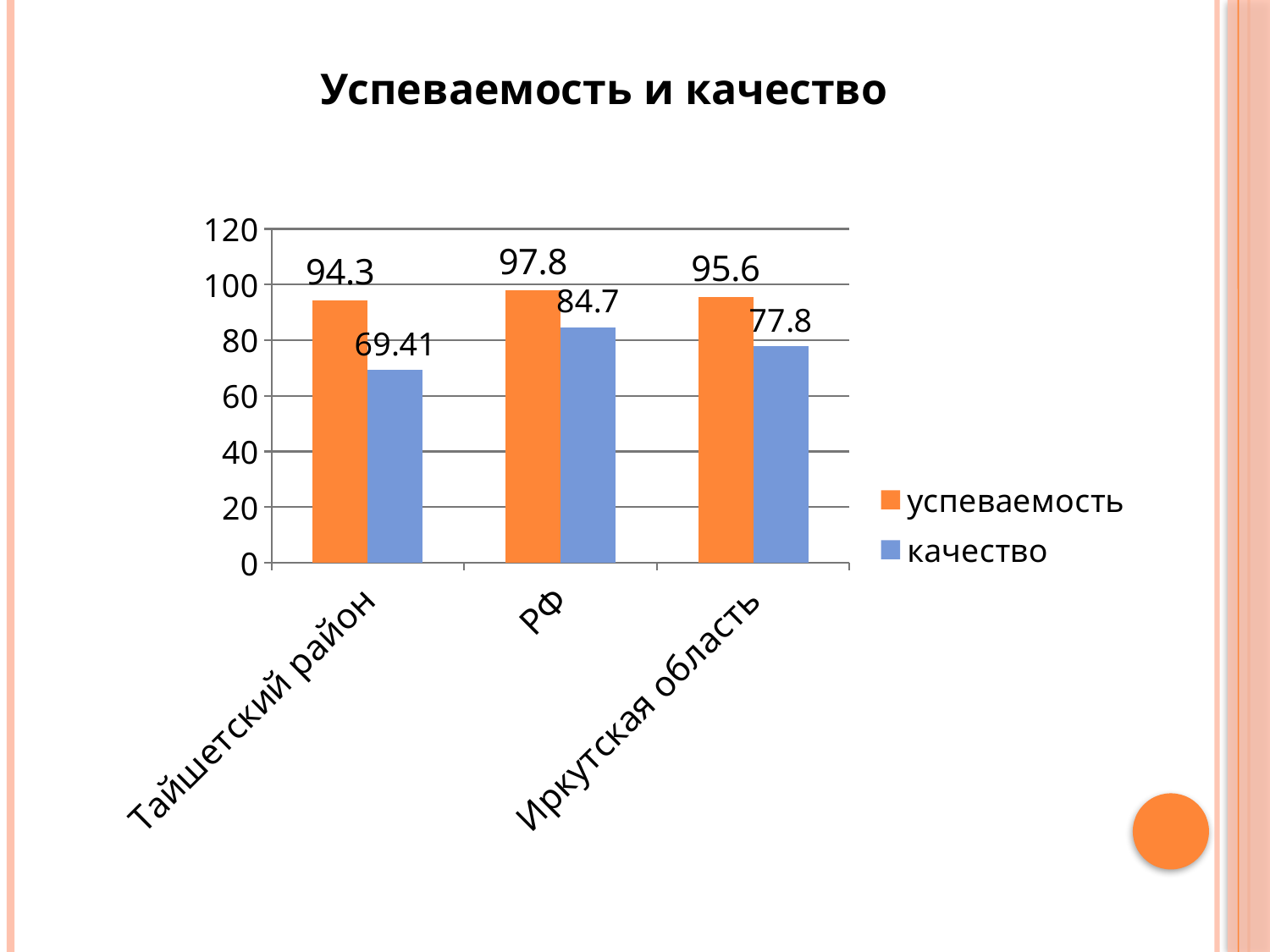
What is the difference between the качество values for РФ and Иркутская область? 6.9 What is the качество value for РФ? 84.7 Which category has the highest успеваемость value? РФ What is the difference between the успеваемость and качество values for Тайшетский район? 24.89 What is the успеваемость value for Тайшетский район? 94.3 What is the качество value for Иркутская область? 77.8 Which is larger: the успеваемость value for Иркутская область or the успеваемость value for Тайшетский район? Иркутская область What kind of chart is shown on the slide? bar chart Which category has the lowest качество value? Тайшетский район What is the title of the chart? Успеваемость и качество How many series does the legend list? 2 How many categories are shown on the x axis? 3